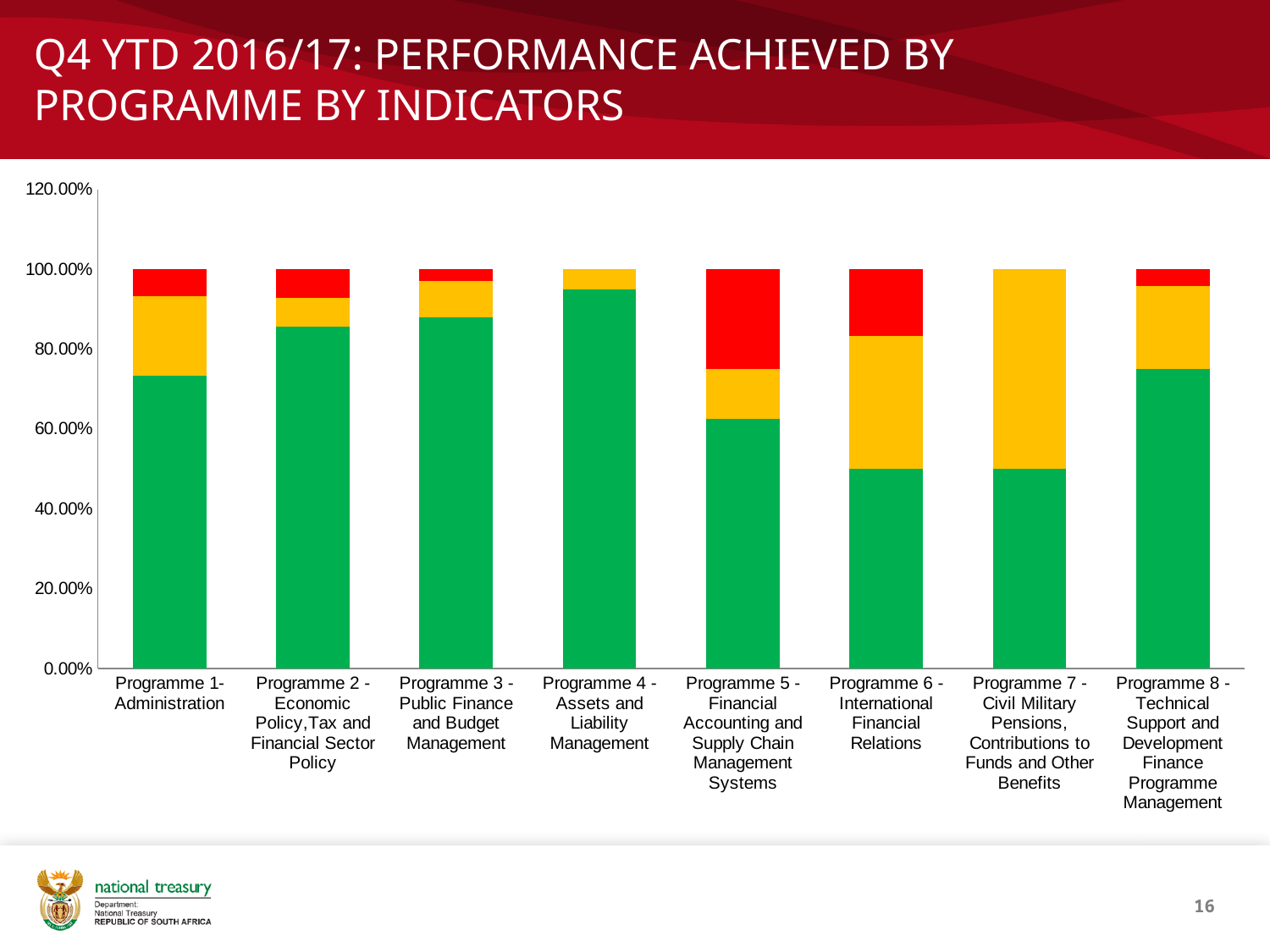
Is the green segment for Programme 5 - Financial Accounting and Supply Chain Management Systems greater or less than 80.00%? less Which has the taller green segment: Programme 2 - Economic Policy, Tax and Financial Sector Policy or Programme 5 - Financial Accounting and Supply Chain Management Systems? Programme 2 - Economic Policy, Tax and Financial Sector Policy Is the green segment for Programme 6 - International Financial Relations greater or less than 60.00%? less What kind of chart is shown on the slide? Stacked bar chart Is the green segment for Programme 4 - Assets and Liability Management greater or less than 80.00%? greater Which programme has the tallest green segment? Programme 4 - Assets and Liability Management What is the total height of the stacked bar for Programme 1 - Administration? 100.00% How many different segment colours are used in the stacked bars? 3 How many programmes are shown on the x axis of the chart? 8 Which has the taller green segment: Programme 3 - Public Finance and Budget Management or Programme 8 - Technical Support and Development Finance Programme Management? Programme 3 - Public Finance and Budget Management Which programme has the largest red segment? Programme 5 - Financial Accounting and Supply Chain Management Systems